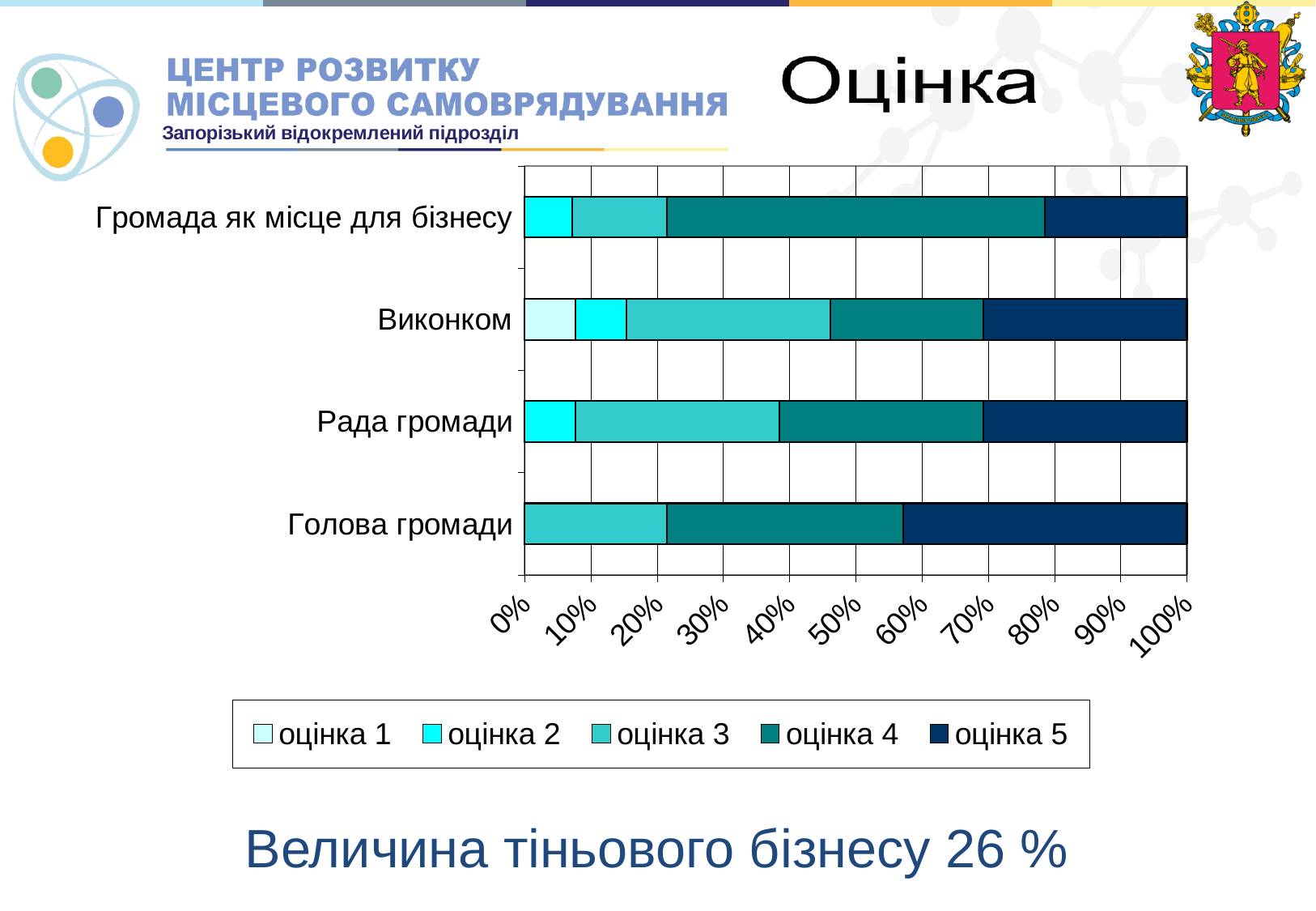
How many categories are plotted on the chart? 4 What is the total of the stacked bar for Голова громади? 100% Which category is the only one with an оцінка 1 segment? Виконком Is the оцінка 3 segment for Виконком greater or less than 20%? greater Is the оцінка 1 segment for Виконком greater or less than 10%? less Which has the larger оцінка 5 segment: Голова громади or Громада як місце для бізнесу? Голова громади Which category has the largest оцінка 4 segment? Громада як місце для бізнесу What kind of chart is shown on the slide? stacked bar chart How many series does the legend list? 5 Is the оцінка 5 segment for Голова громади greater or less than 30%? greater What is the last entry in the chart legend? оцінка 5